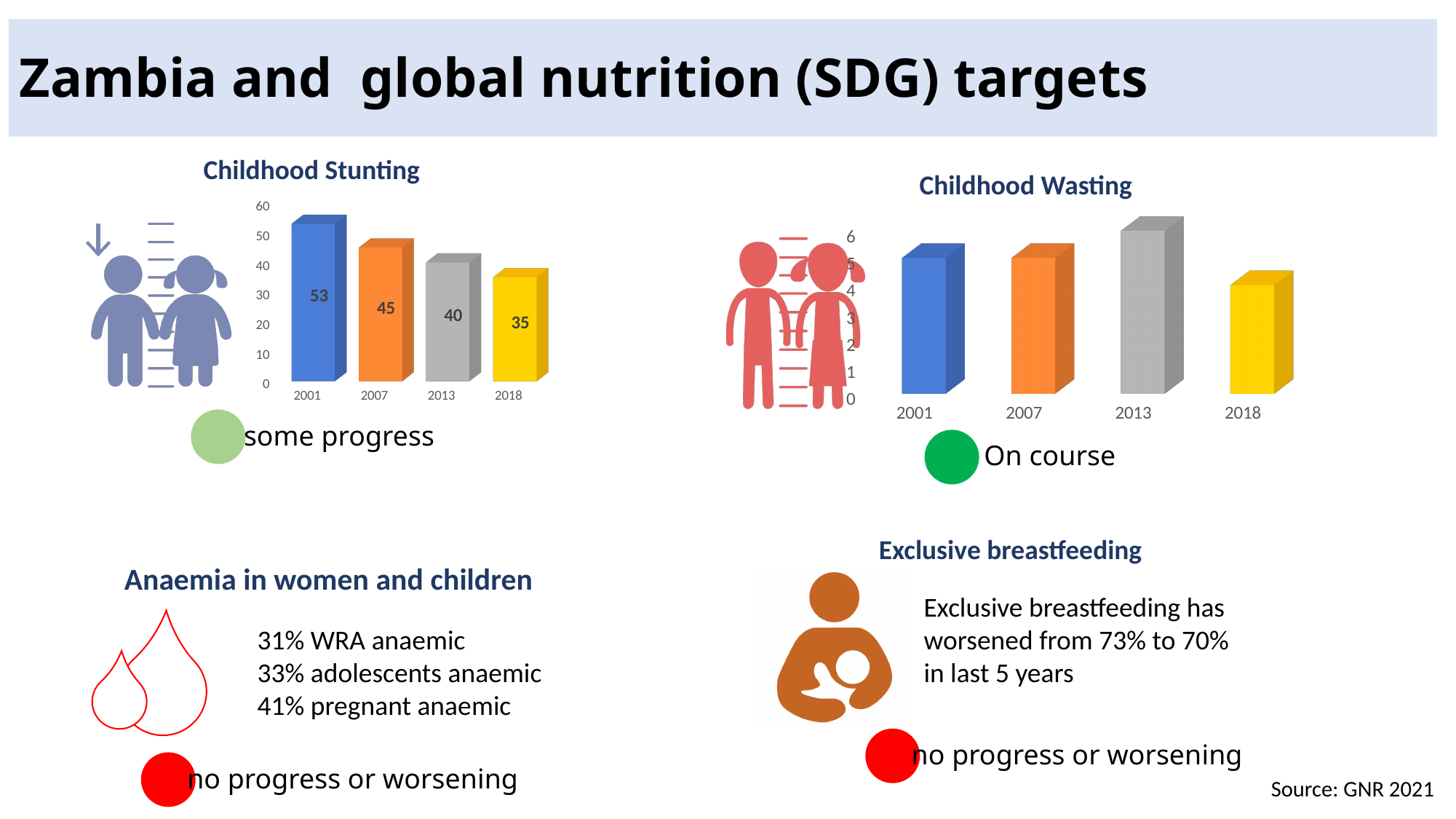
In the Childhood Stunting chart, what is the value for 2007? 45 In the Childhood Stunting chart, what is the difference between the 2001 and 2018 values? 18 In the Childhood Stunting chart, what is the value for 2001? 53 In the Childhood Stunting chart, which year has the highest value? 2001 In the Childhood Wasting chart, which year has the lowest value? 2018 How many years are shown in the Childhood Stunting chart? 4 In the Childhood Stunting chart, what is the value for 2018? 35 In the Childhood Wasting chart, is the value for 2013 greater or less than 5? greater In the Childhood Wasting chart, is the value for 2018 greater or less than 5? less In the Childhood Stunting chart, do the values rise or fall from 2001 to 2018? fall What kind of chart is the Childhood Wasting chart? bar chart In the Childhood Wasting chart, which year has the highest value? 2013